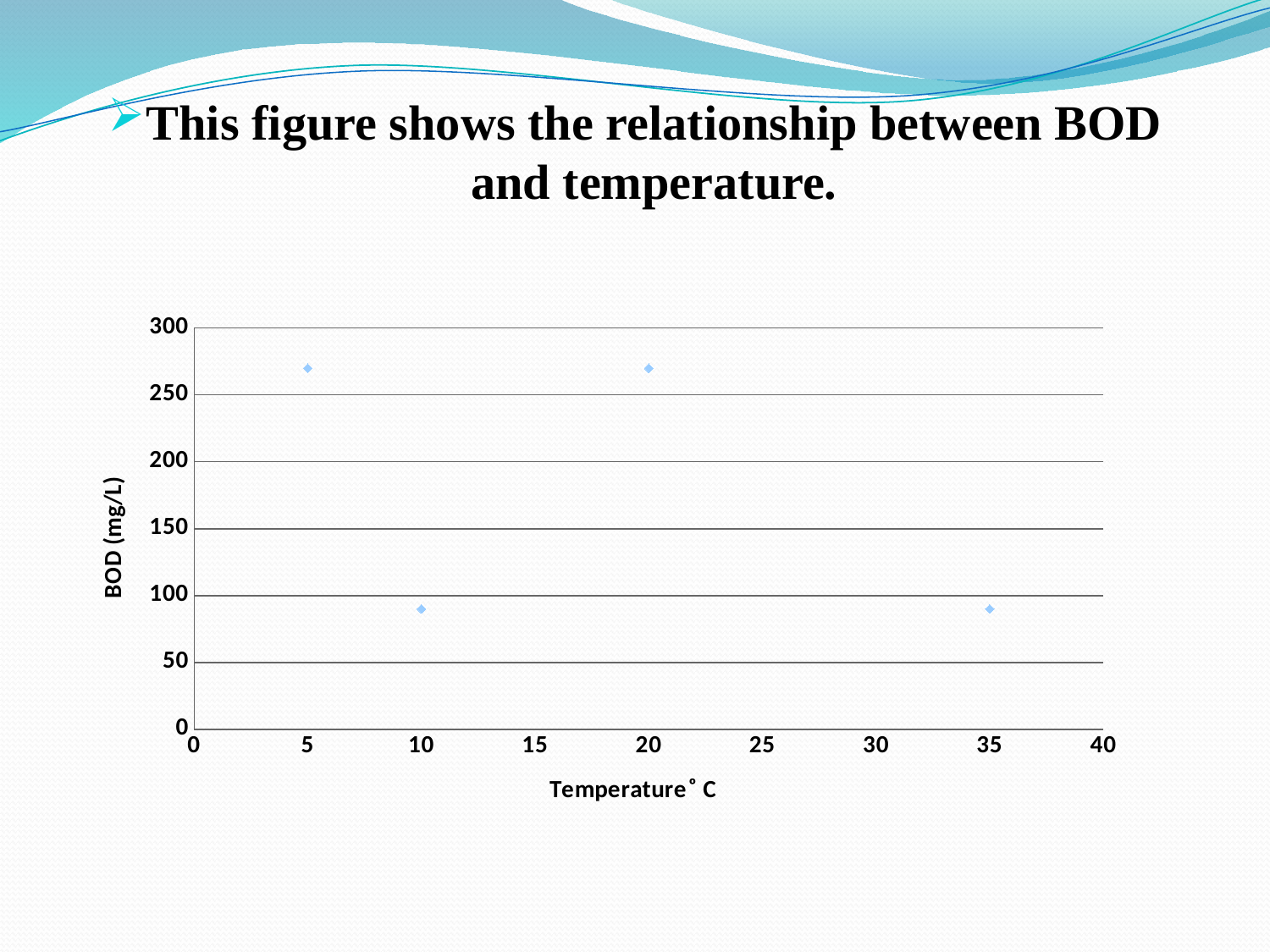
Is the BOD value at a temperature of 35 greater or less than 50? greater What kind of chart is shown on the slide? scatter chart How many data points are plotted on the chart? 4 Which has the larger BOD value: the point at temperature 20 or the point at temperature 35? temperature 20 Is the BOD value at a temperature of 35 greater or less than 100? less Is the BOD value at a temperature of 5 greater or less than 250? greater What is the highest value shown on the vertical axis? 300 What is the label of the vertical axis? BOD (mg/L) Which has the larger BOD value: the point at temperature 5 or the point at temperature 10? temperature 5